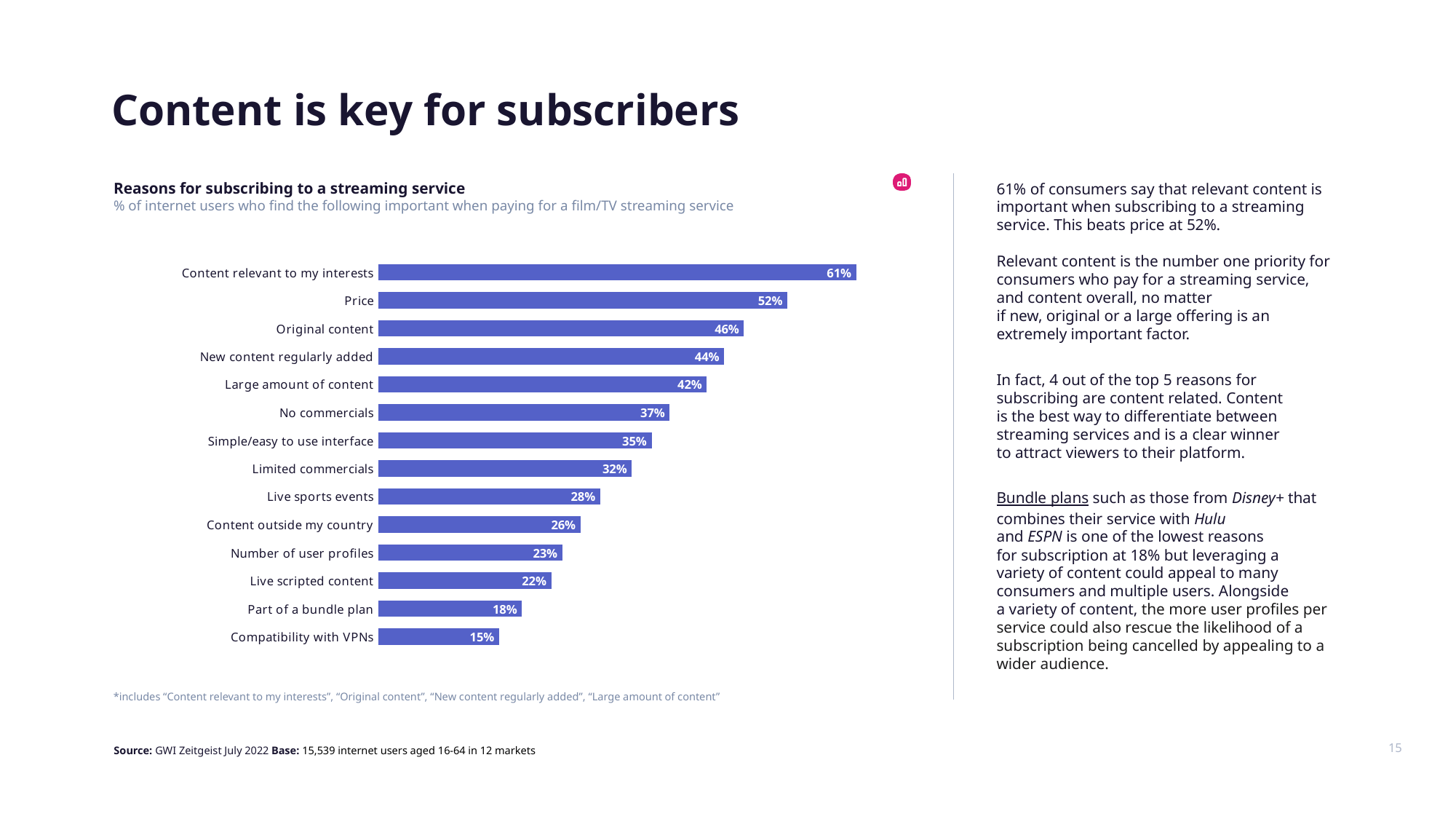
Which has a higher value: 'Original content' or 'New content regularly added'? Original content What is the title of the chart? Reasons for subscribing to a streaming service Which has a lower value: 'Number of user profiles' or 'Content outside my country'? Number of user profiles What kind of chart is used to show the reasons for subscribing to a streaming service? Bar chart How many reasons for subscribing are shown in the chart? 14 Which reason for subscribing has the lowest percentage? Compatibility with VPNs What is the difference between the values for 'Live sports events' and 'Live scripted content'? 6% Which reason for subscribing has the highest percentage? Content relevant to my interests What is the value shown for 'Part of a bundle plan'? 18% What is the value shown for 'No commercials'? 37% What percentage of internet users find 'Price' important when paying for a film/TV streaming service? 52% What is the difference between the values for 'Content relevant to my interests' and 'Price'? 9%